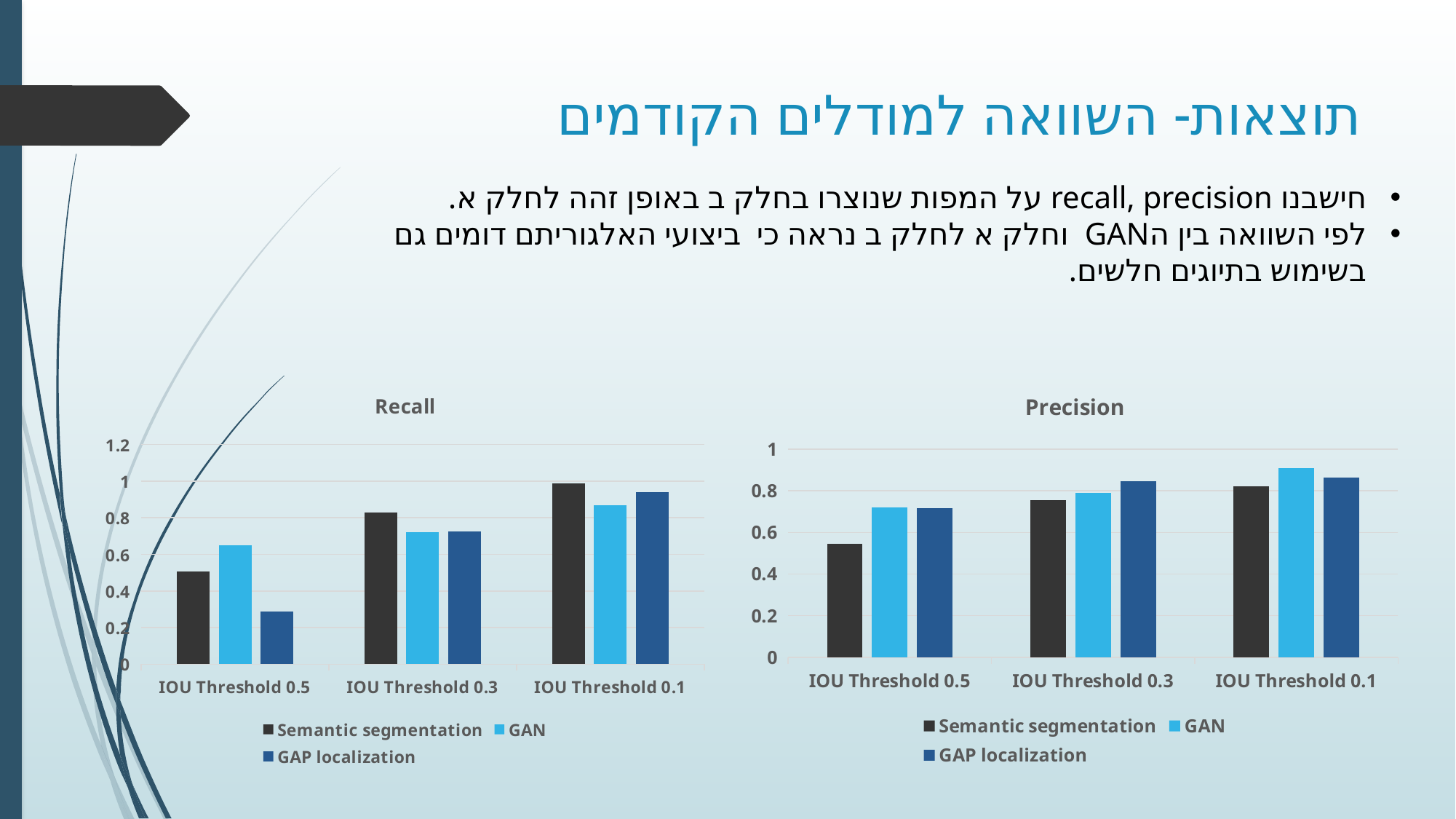
In the Recall chart, do the Semantic segmentation values rise or fall from IOU Threshold 0.5 to IOU Threshold 0.1? rise In the Precision chart, which series has the highest value at IOU Threshold 0.1? GAN In the Recall chart, how many series does the legend list? 3 In the Precision chart, at IOU Threshold 0.5, which is larger: Semantic segmentation or GAN? GAN In the Recall chart, is the value for GAP localization at IOU Threshold 0.5 greater or less than 0.4? less In the Recall chart, which series has the lowest value at IOU Threshold 0.5? GAP localization In the Recall chart, what kind of chart is shown? bar chart In the Recall chart, is the value for Semantic segmentation at IOU Threshold 0.1 greater or less than 0.8? greater In the Recall chart, how many IOU threshold categories are shown on the x axis? 3 In the Precision chart, is the value for GAN at IOU Threshold 0.1 greater or less than 0.8? greater In the Precision chart, which series has the lowest value at IOU Threshold 0.3? Semantic segmentation